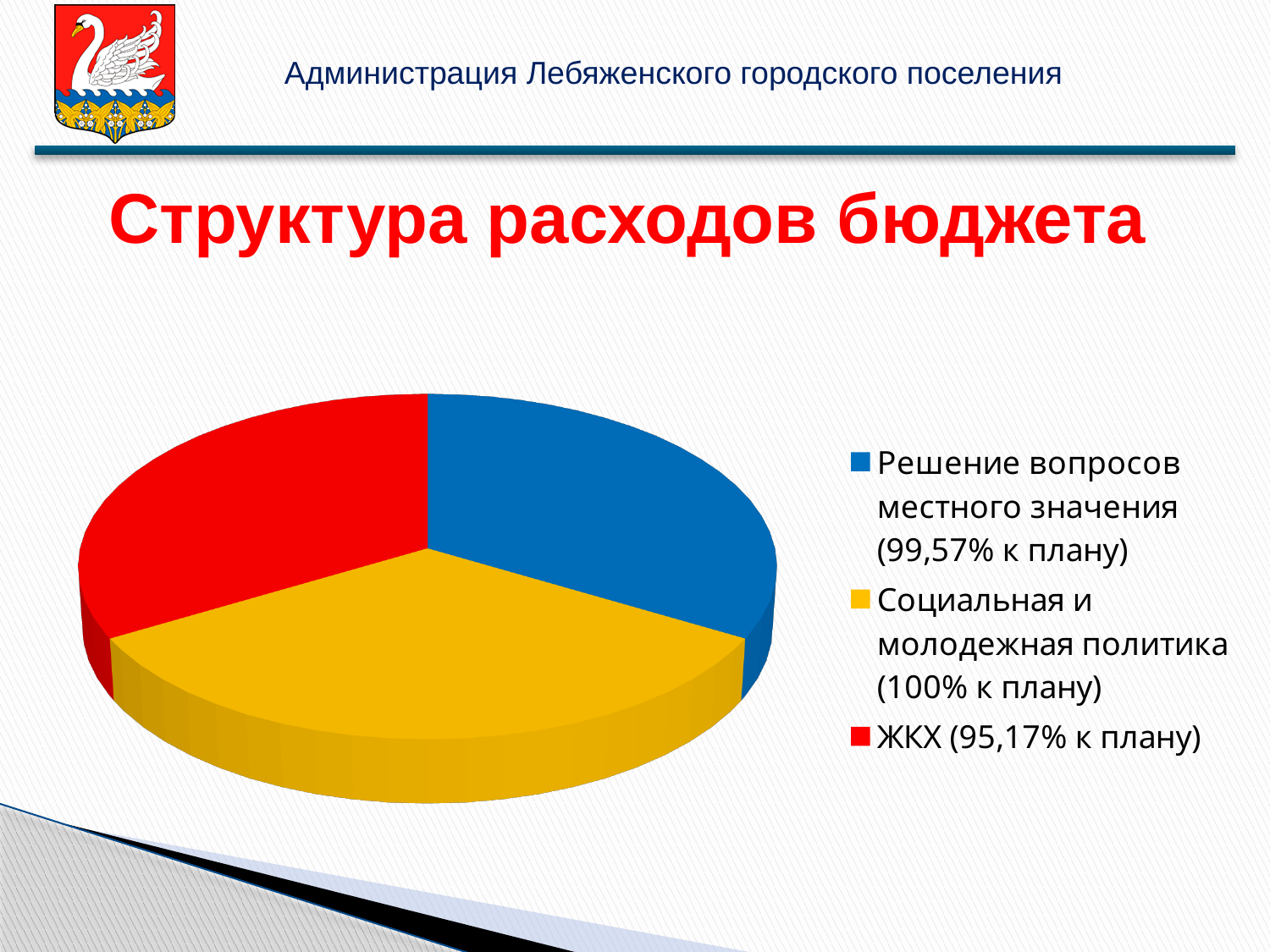
Which category does the blue slice of the pie chart represent? Решение вопросов местного значения According to the legend, what percentage of the plan was achieved for Решение вопросов местного значения? 99,57% According to the legend, what percentage of the plan was achieved for ЖКХ? 95,17% What is the title of the chart on the slide? Структура расходов бюджета How many entries does the legend of the pie chart list? 3 According to the legend, what percentage of the plan was achieved for Социальная и молодежная политика? 100% How many slices does the pie chart have? 3 Which colour represents ЖКХ in the pie chart? red What kind of chart is shown on the slide? pie chart